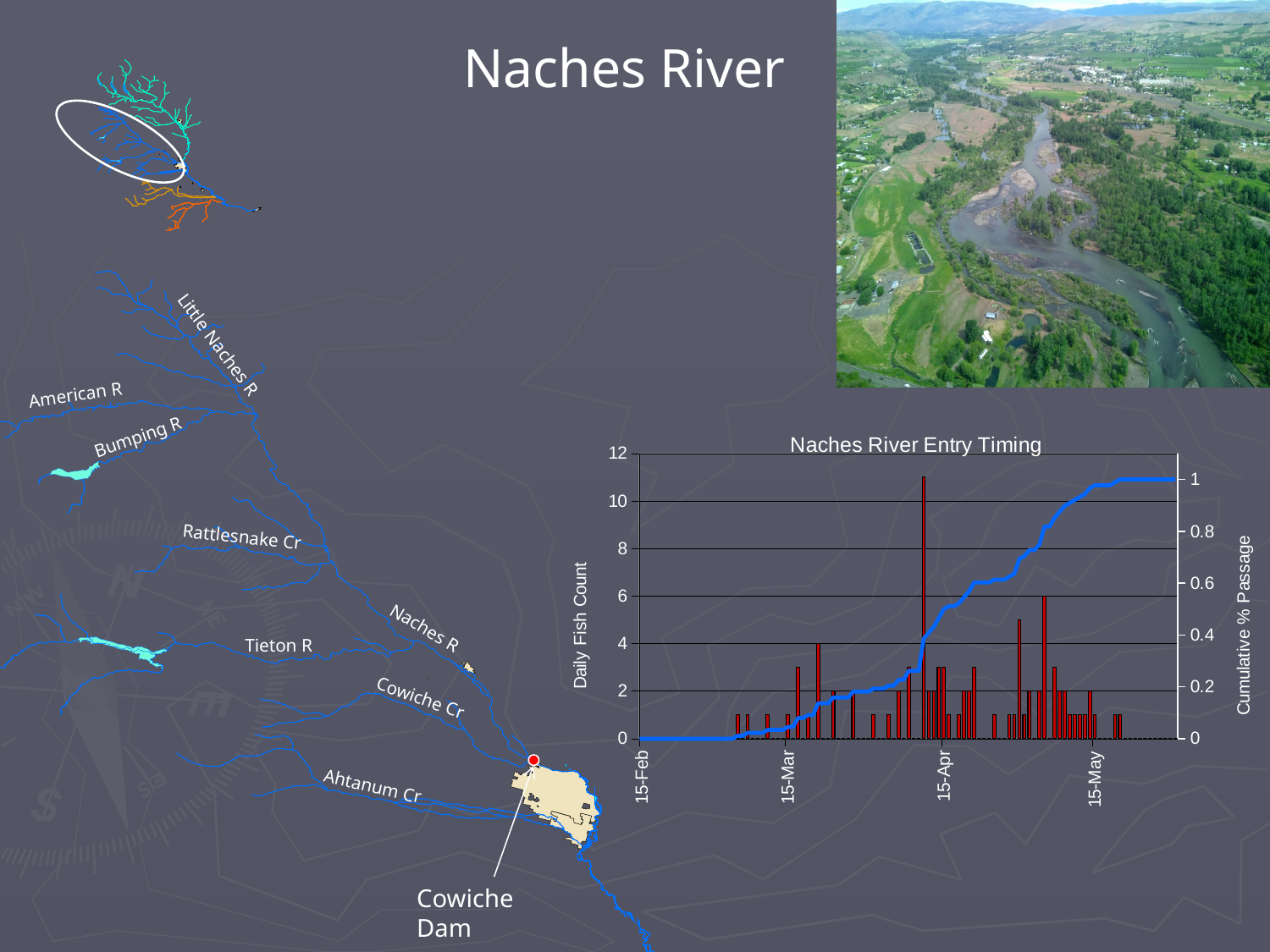
In the Naches River Entry Timing chart, is the Cumulative % Passage at 15-Mar greater or less than 0.2? less What is the title of the chart on the slide? Naches River Entry Timing In the Naches River Entry Timing chart, does the tallest Daily Fish Count bar occur before or after 15-Apr? before What is the label of the left vertical axis in the Naches River Entry Timing chart? Daily Fish Count In the Naches River Entry Timing chart, is the Cumulative % Passage at 15-Apr greater or less than 0.2? greater In the Naches River Entry Timing chart, is the tallest Daily Fish Count bar greater or less than 10? greater What is the highest value shown on the left vertical axis of the Naches River Entry Timing chart? 12 What kind of chart is used to show the Daily Fish Count in the Naches River Entry Timing chart? bar chart What is the highest value shown on the right vertical axis of the Naches River Entry Timing chart? 1 In the Naches River Entry Timing chart, does the Cumulative % Passage line rise or fall from 15-Feb to 15-May? rise How many date labels are shown on the x axis of the Naches River Entry Timing chart? 4